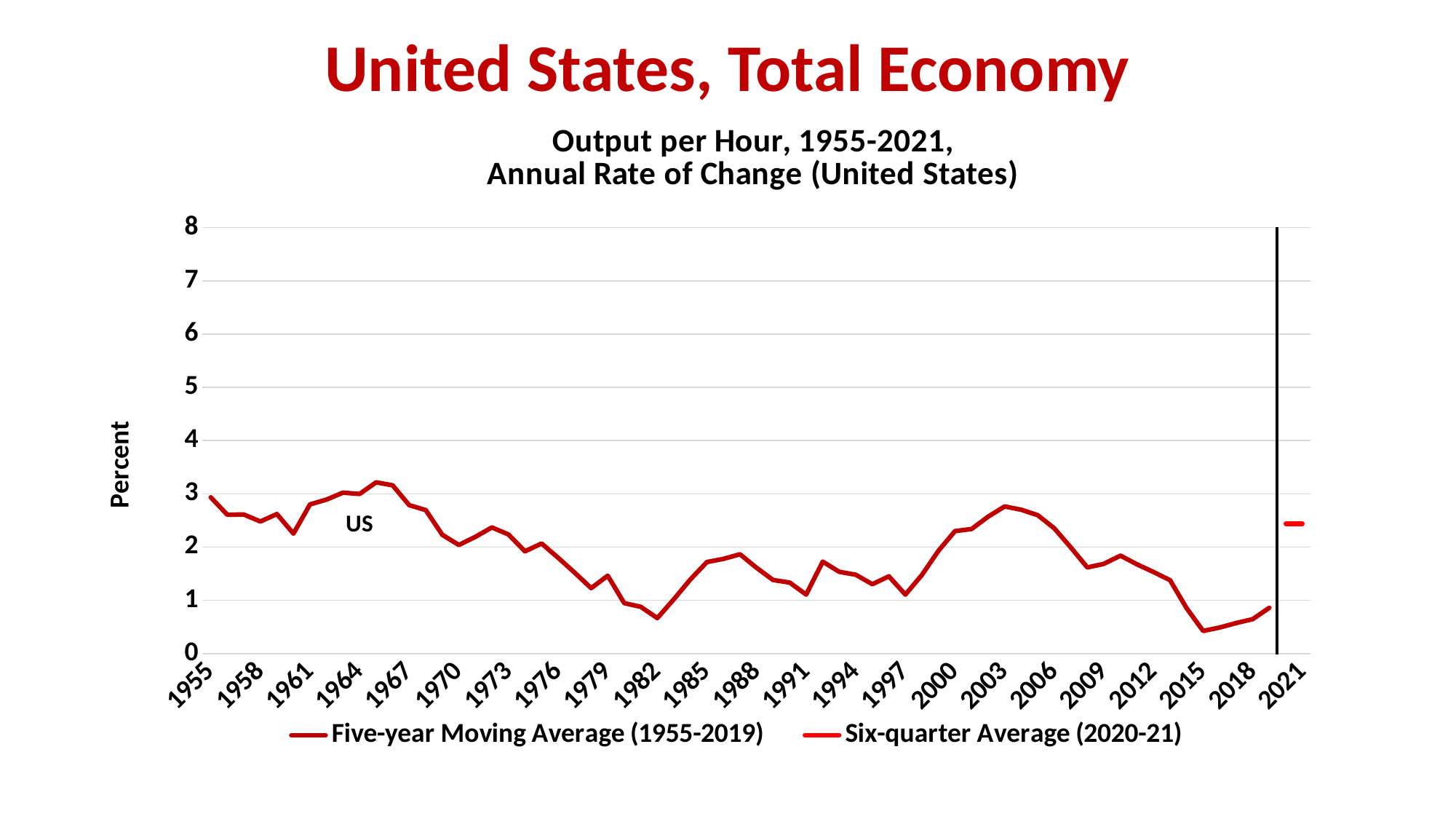
Does the Five-year Moving Average rise or fall between 1982 and 1988? rise Is the Five-year Moving Average value for 1982 greater or less than 1? less Does the Five-year Moving Average rise or fall between 2003 and 2015? fall Which is larger, the Five-year Moving Average value for 1966 or for 1982? 1966 Is the Six-quarter Average (2020-21) value shown at 2021 greater or less than 2? greater Is the Five-year Moving Average value for 1979 greater or less than 2? less What kind of chart is shown on the slide? line chart What is the label on the vertical axis? Percent How many series does the legend list? 2 What is the title of the chart? Output per Hour, 1955-2021, Annual Rate of Change (United States)